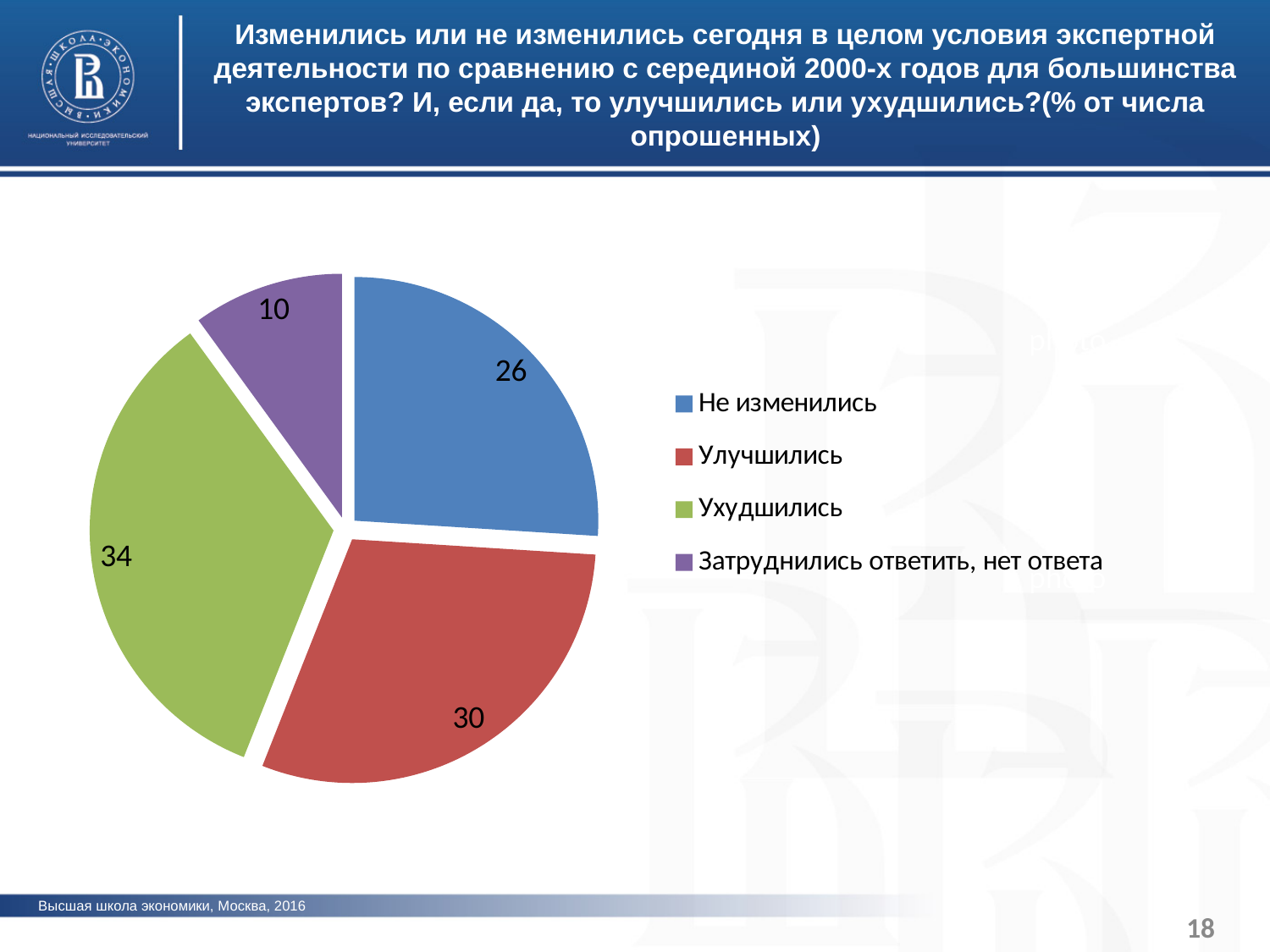
What is the value for "Затруднились ответить, нет ответа"? 10 What is the value for "Ухудшились"? 34 Which category has the largest share of the pie? Ухудшились Which category has the smallest share of the pie? Затруднились ответить, нет ответа What is the value for "Не изменились"? 26 What is the value for "Улучшились"? 30 What is the total of the values for "Улучшились" and "Ухудшились"? 64 What is the difference between the values for "Ухудшились" and "Не изменились"? 8 How many categories does the pie chart have? 4 Which is larger, the value for "Улучшились" or the value for "Не изменились"? Улучшились What colour is the slice for "Ухудшились"? green What type of chart is shown on the slide? pie chart